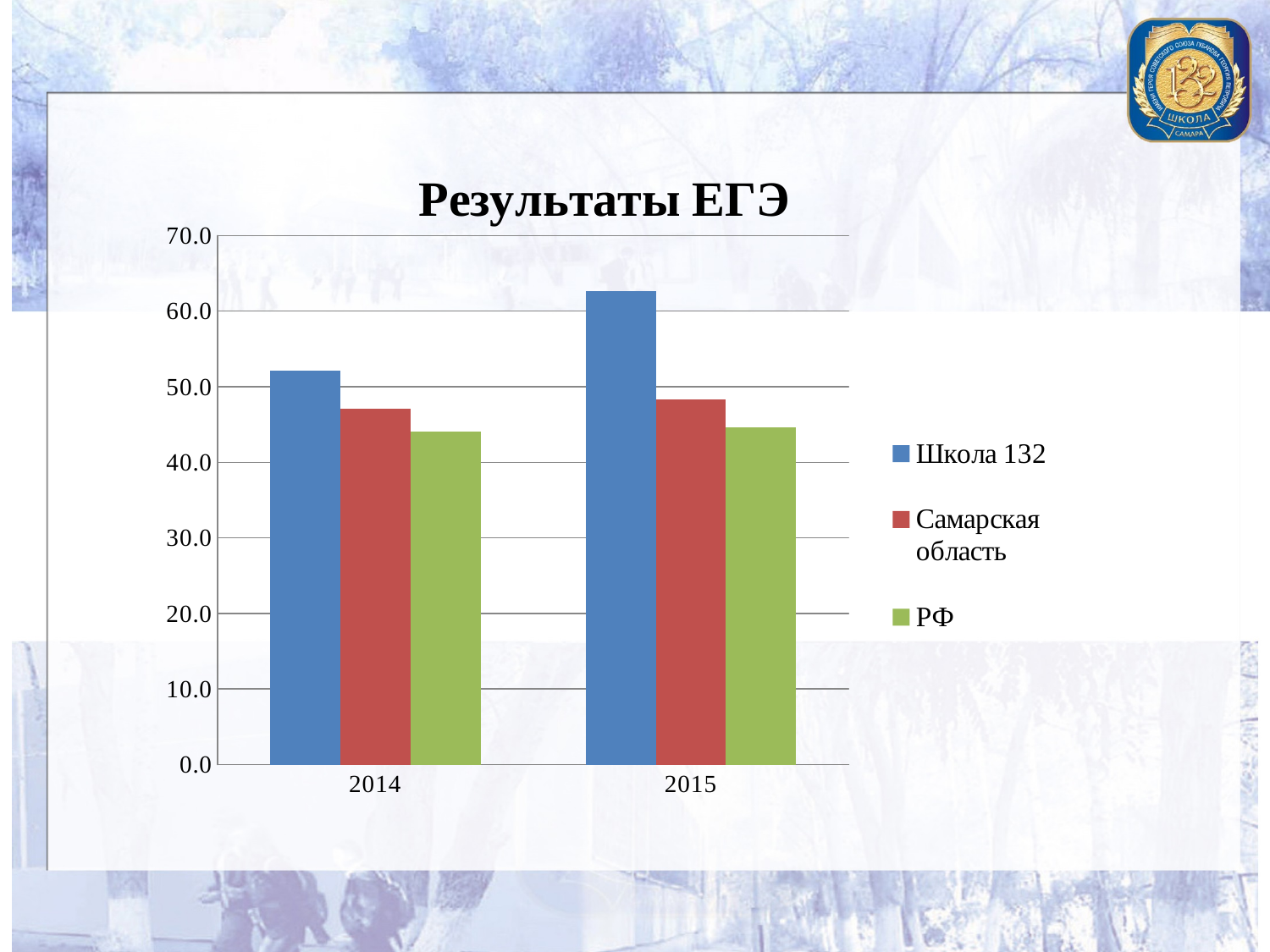
Which series has the highest value in 2015? Школа 132 How many series does the legend list? 3 Which series has the lowest value in 2014? РФ Is the value for Самарская область in 2015 greater or less than 40.0? greater Which is larger in 2014: Школа 132 or Самарская область? Школа 132 How many categories are shown on the x axis? 2 What is the title of the chart? Результаты ЕГЭ Does the value for Школа 132 rise or fall from 2014 to 2015? rise Is the value for РФ in 2014 greater or less than 50.0? less Which series is shown in green in the legend? РФ Is the value for Школа 132 in 2015 greater or less than 60.0? greater What kind of chart is shown on the slide? bar chart